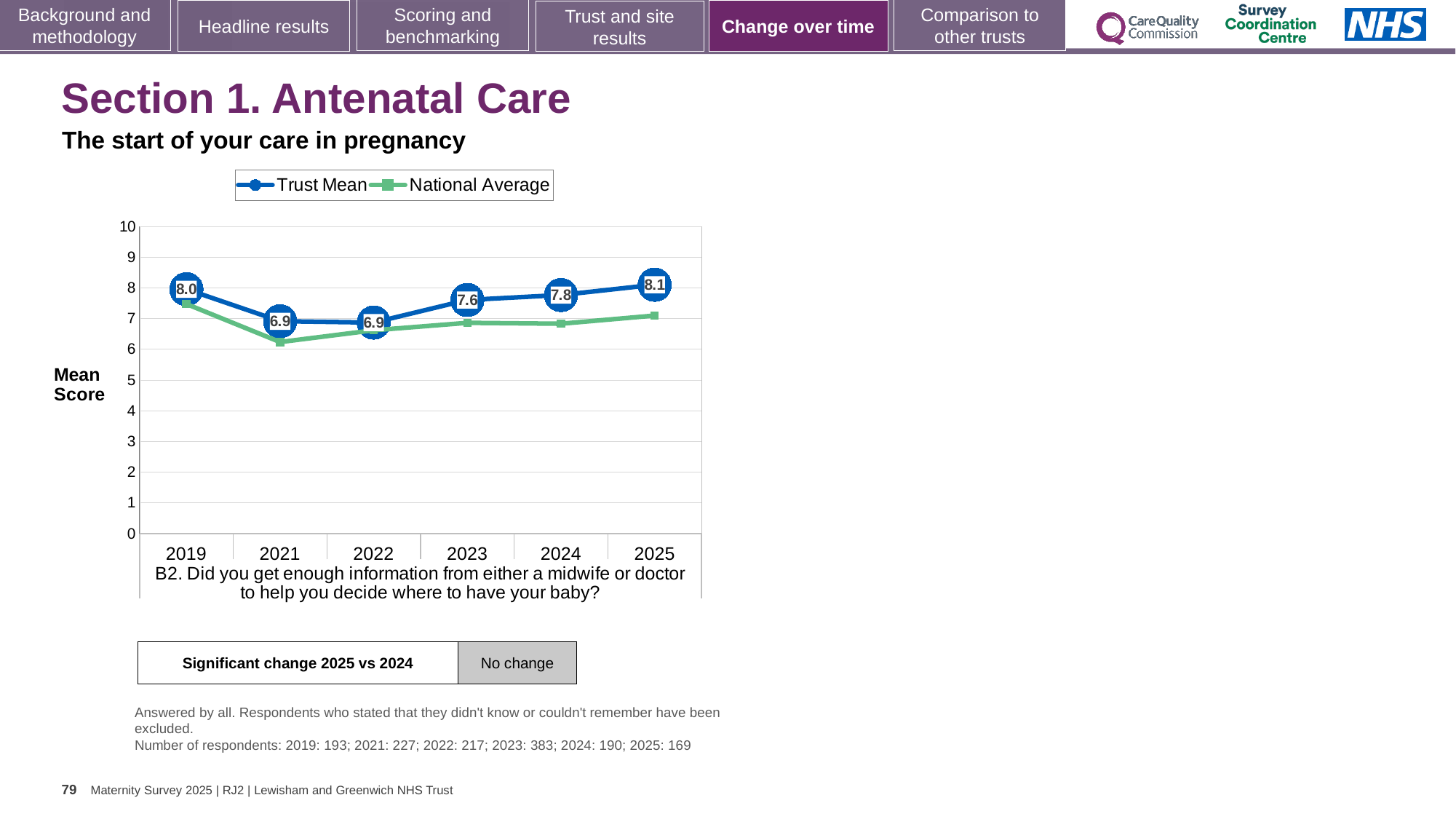
What kind of chart is shown? line chart What is the difference between the Trust Mean in 2025 and in 2024? 0.3 Is the National Average value for 2019 greater or less than 7? greater Is the National Average value for 2021 greater or less than 7? less What is the Trust Mean score for 2025? 8.1 What is the Trust Mean score for 2019? 8.0 Which is larger, the Trust Mean in 2023 or in 2024? 2024 What is the difference between the Trust Mean in 2019 and in 2021? 1.1 In which year is the Trust Mean highest? 2025 What is the Trust Mean score for 2023? 7.6 How many series does the legend list? 2 How many years are shown on the x axis? 6